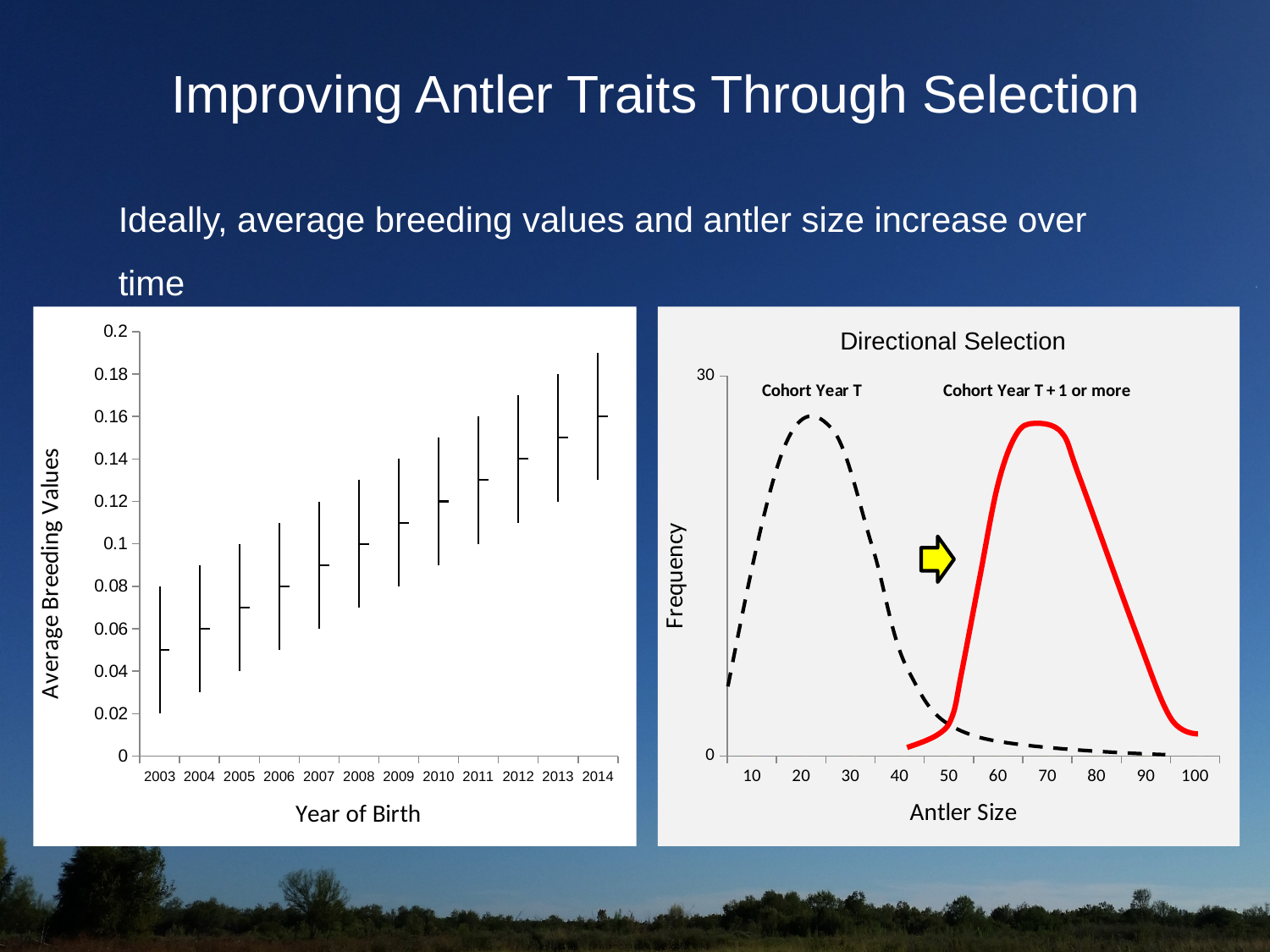
On the left chart, is the average breeding value for 2005 greater or less than 0.08? less On the left chart, which year of birth has the lowest average breeding value? 2003 On the left chart, how many years of birth are plotted on the x axis? 12 On the left chart, which has the larger average breeding value, 2006 or 2012? 2012 On the left chart, what is the average breeding value for the 2008 birth year? 0.1 On the left chart, do average breeding values rise or fall as year of birth increases? rise On the left chart, which year of birth has the highest average breeding value? 2014 On the Directional Selection chart, which cohort curve peaks at a larger antler size? Cohort Year T + 1 or more On the left chart, what is the average breeding value for the 2004 birth year? 0.06 On the Directional Selection chart, how many cohort curves are plotted? 2 On the left chart, is the average breeding value for 2011 greater or less than 0.12? greater On the left chart, what is the average breeding value for the 2014 birth year? 0.16